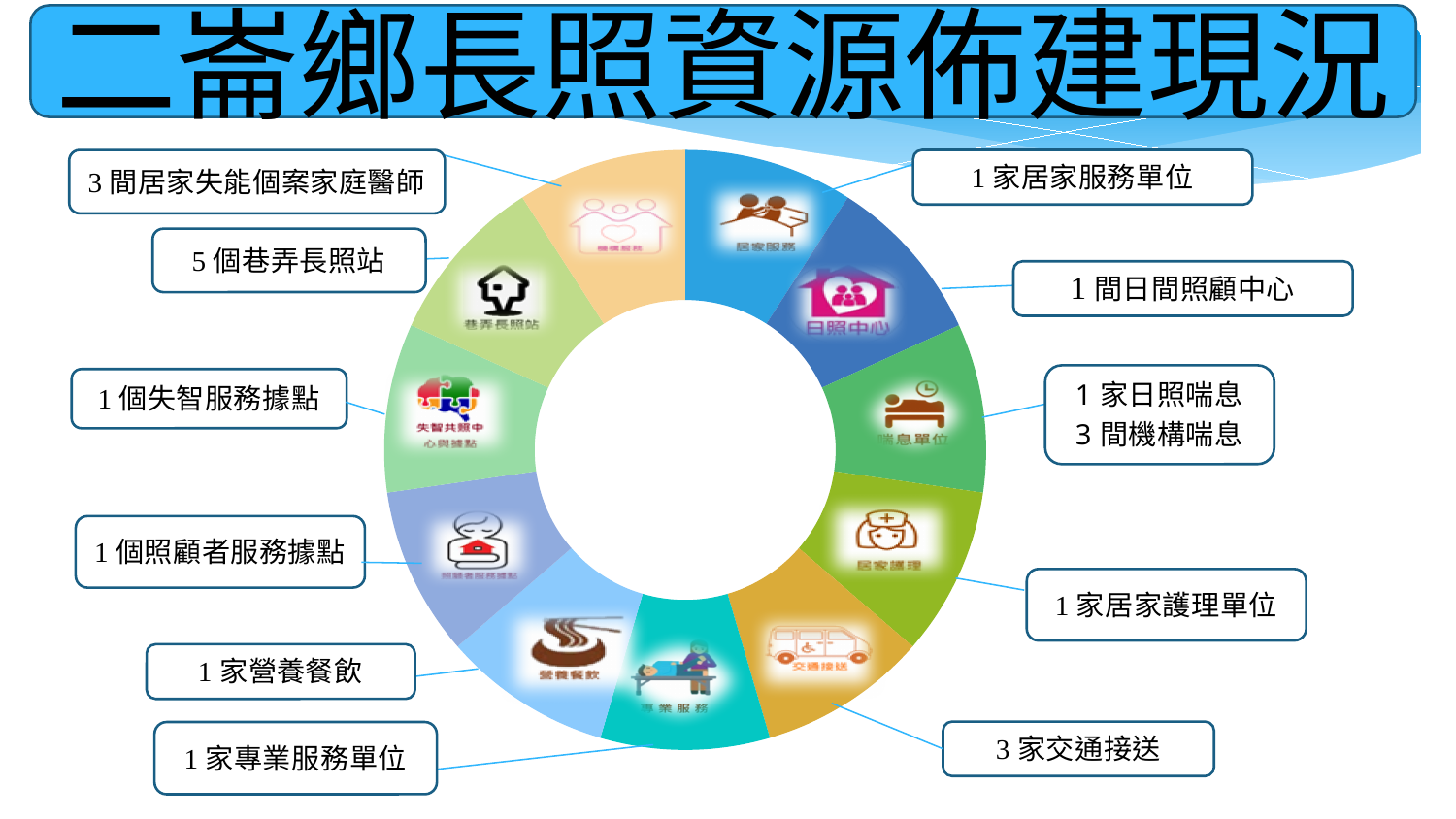
How many 機構喘息 are listed? 3 間 Which resource type has the largest number listed in its callout? 巷弄長照站 (5 個) How many 居家失能個案家庭醫師 are listed? 3 間 How many 巷弄長照站 are listed in the callout? 5 個 How many 交通接送 providers are listed? 3 家 How many 日間照顧中心 are listed? 1 間 Which has more listed: 交通接送 or 居家護理單位? 交通接送 How many 失智服務據點 are listed? 1 個 How many segments does the ring diagram have? 11 What is the difference between the number of 巷弄長照站 and the number of 交通接送? 2 What is the title of the slide? 二崙鄉長照資源佈建現況 What kind of diagram is shown on the slide? A ring (donut) diagram